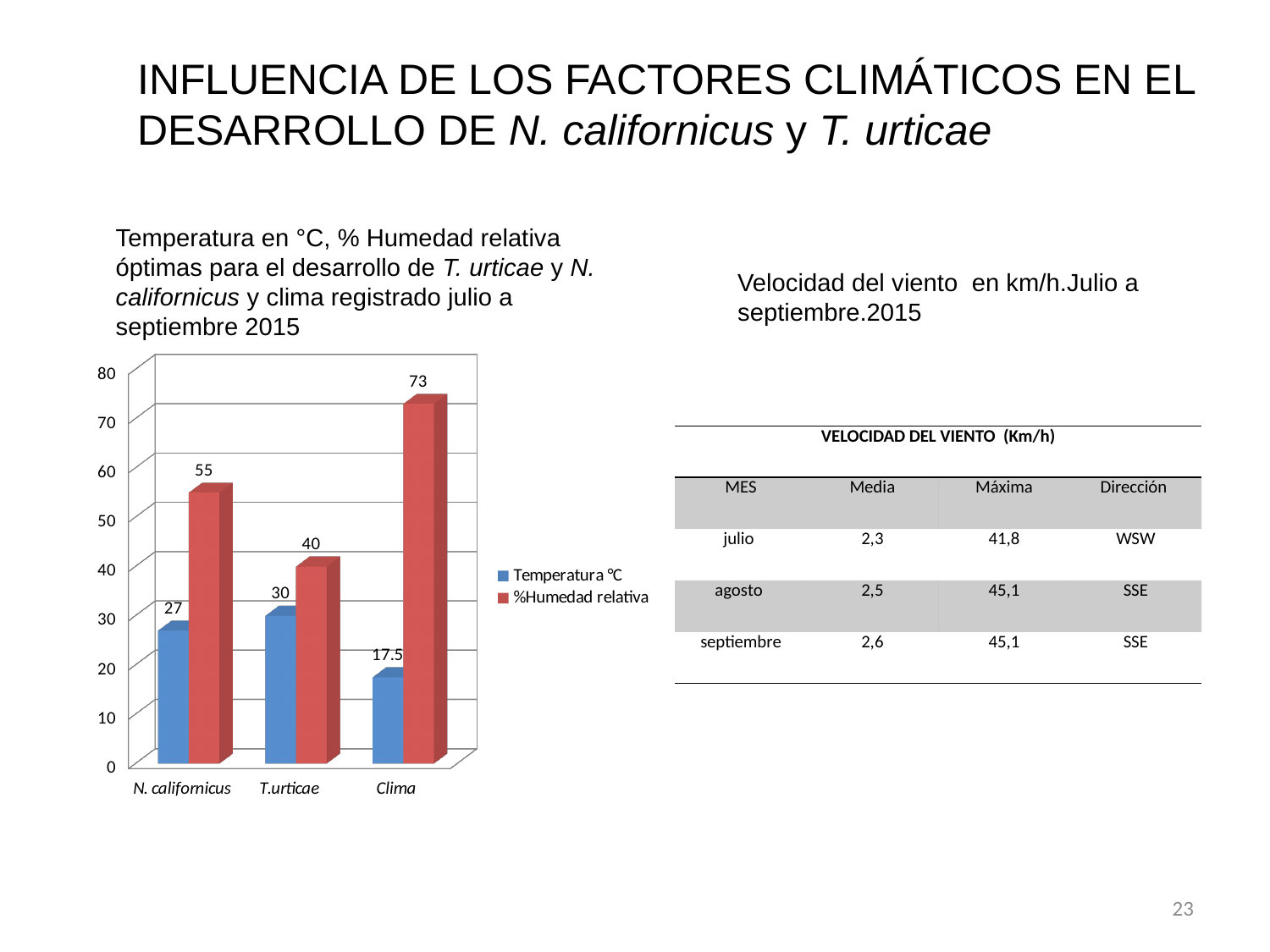
What colour are the %Humedad relativa bars in the chart? red What is the Temperatura °C value for N. californicus? 27 What is the %Humedad relativa value for T.urticae? 40 What is the %Humedad relativa value for Clima? 73 Which is larger, the Temperatura °C value for T.urticae or for N. californicus? T.urticae How many categories are shown on the x axis of the chart? 3 Which category has the lowest Temperatura °C value? Clima What is the difference between the %Humedad relativa values for N. californicus and T.urticae? 15 Which category has the highest %Humedad relativa value? Clima What kind of chart is shown on the slide? bar chart What is the Temperatura °C value for Clima? 17.5 How many series does the chart legend list? 2